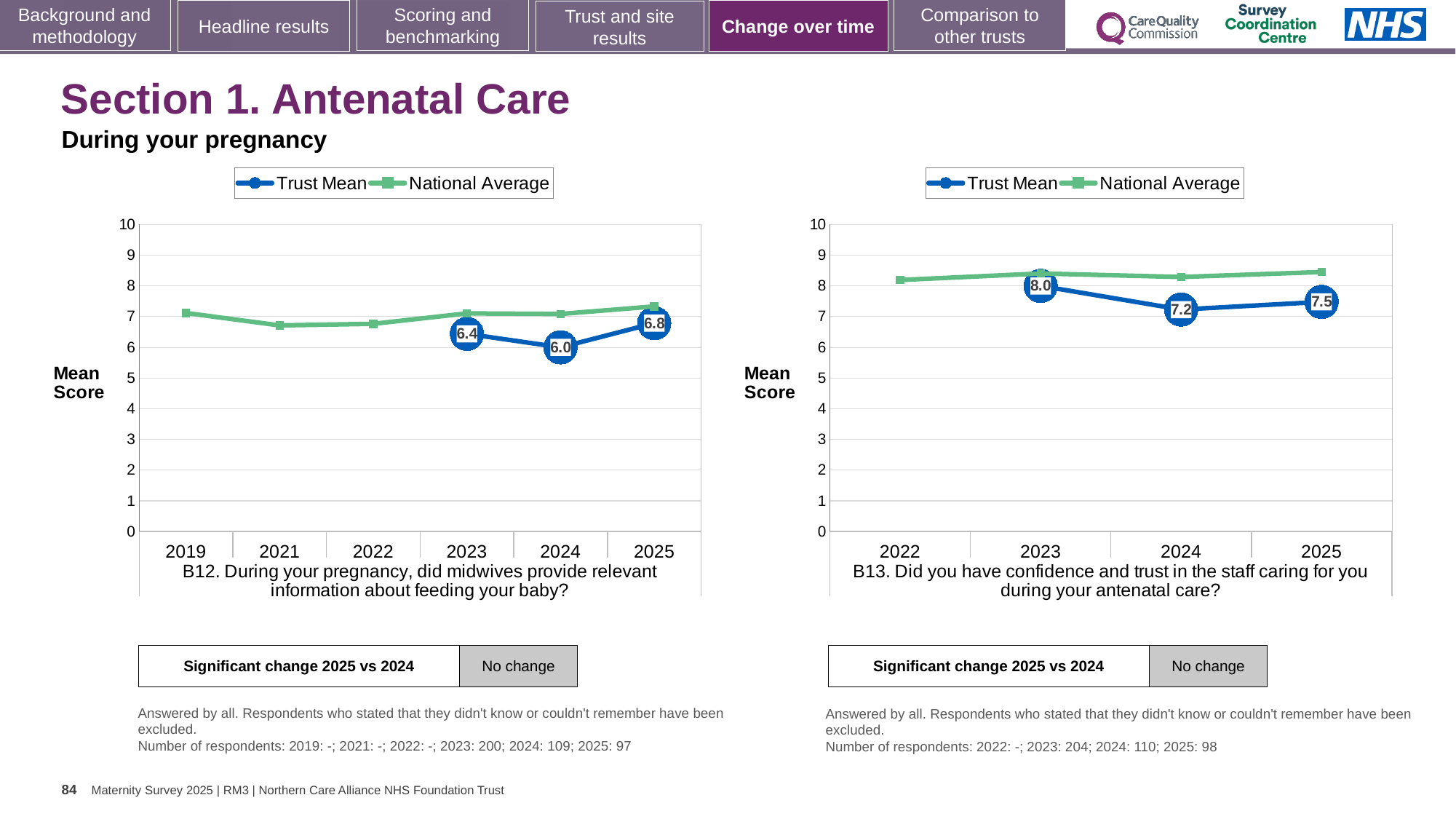
What type of chart is the B12 chart (left)? Line chart In the B12 chart (left), what is the Trust Mean for 2024? 6.0 In the B13 chart (right), is the Trust Mean for 2025 greater or less than the Trust Mean for 2024? greater In the B13 chart (right), which year has the highest Trust Mean? 2023 In the B12 chart (left), which year has the lowest Trust Mean? 2024 In the B13 chart (right), what is the difference between the Trust Mean for 2023 and 2024? 0.8 How many years are shown on the x axis of the B13 chart (right)? 4 In the B12 chart (left), what is the Trust Mean for 2025? 6.8 In the B13 chart (right), what is the Trust Mean for 2024? 7.2 In the B13 chart (right), what is the Trust Mean for 2023? 8.0 In the B12 chart (left), what is the difference between the Trust Mean for 2025 and 2024? 0.8 In the B12 chart (left), is the National Average for 2021 greater or less than 7? less